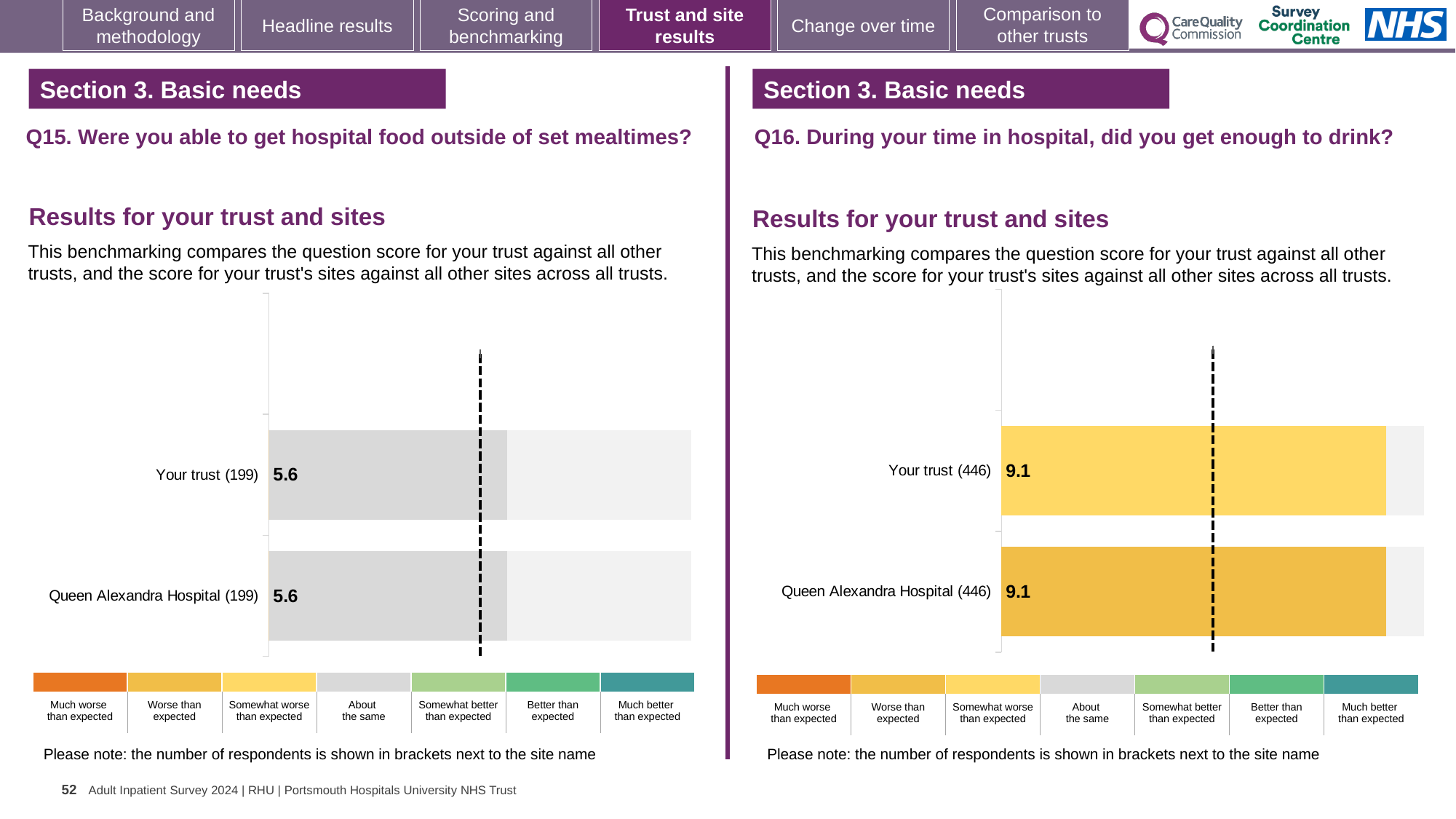
In the Q16 chart on the right, what is the score for Queen Alexandra Hospital? 9.1 In the Q15 chart on the left, what is the score for Queen Alexandra Hospital? 5.6 How many bars are plotted in the Q16 chart on the right? 2 What kind of chart is the Q15 chart on the left? Bar chart In the Q15 chart on the left, how many respondents are shown in brackets for Your trust? 199 In the Q16 chart on the right, which benchmark category does the colour of the Queen Alexandra Hospital bar correspond to in the legend? Worse than expected In the Q16 chart on the right, what is the score for Your trust? 9.1 In the Q16 chart on the right, how many respondents are shown in brackets for Queen Alexandra Hospital? 446 In the Q15 chart on the left, what is the difference between the score for Your trust and the score for Queen Alexandra Hospital? 0 How many bars are plotted in the Q15 chart on the left? 2 In the Q16 chart on the right, what is the difference between the score for Your trust and the score for Queen Alexandra Hospital? 0 In the Q15 chart on the left, what is the score for Your trust? 5.6